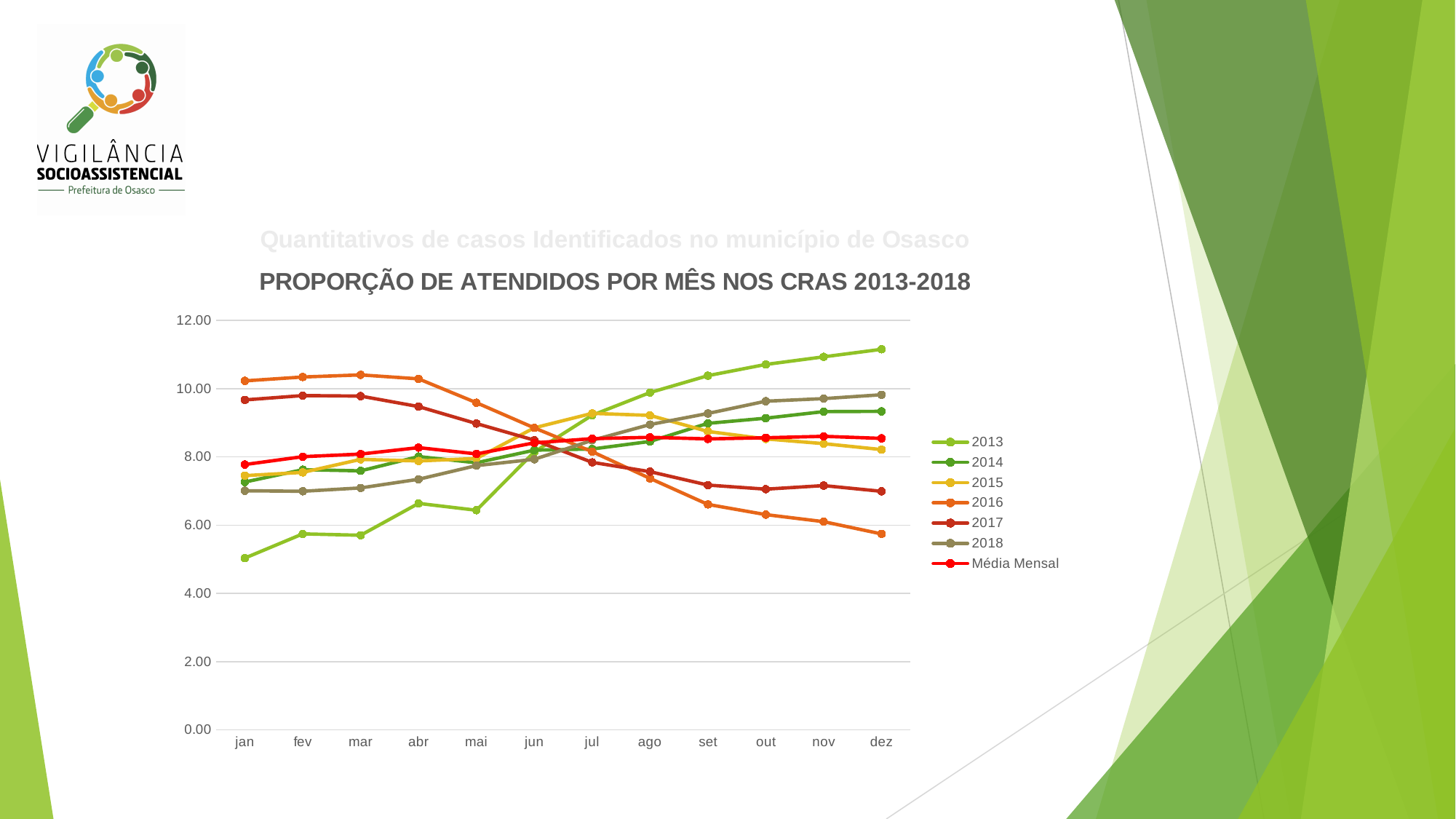
Do the values for 2013 rise or fall from jan to dez? rise What is the title of the chart? PROPORÇÃO DE ATENDIDOS POR MÊS NOS CRAS 2013-2018 Is the value for 2013 in jan greater or less than 6.00? less Which series has the highest value in dez? 2013 In dez, which is larger: the value for 2016 or the value for 2017? 2017 Which series has the lowest value in jan? 2013 How many months are shown along the x axis? 12 How many series does the legend list? 7 Is the value for 2017 in dez greater or less than 8.00? less What kind of chart is shown on the slide? line chart Do the values for 2016 rise or fall from jan to dez? fall Is the value for 2016 in mar greater or less than 10.00? greater